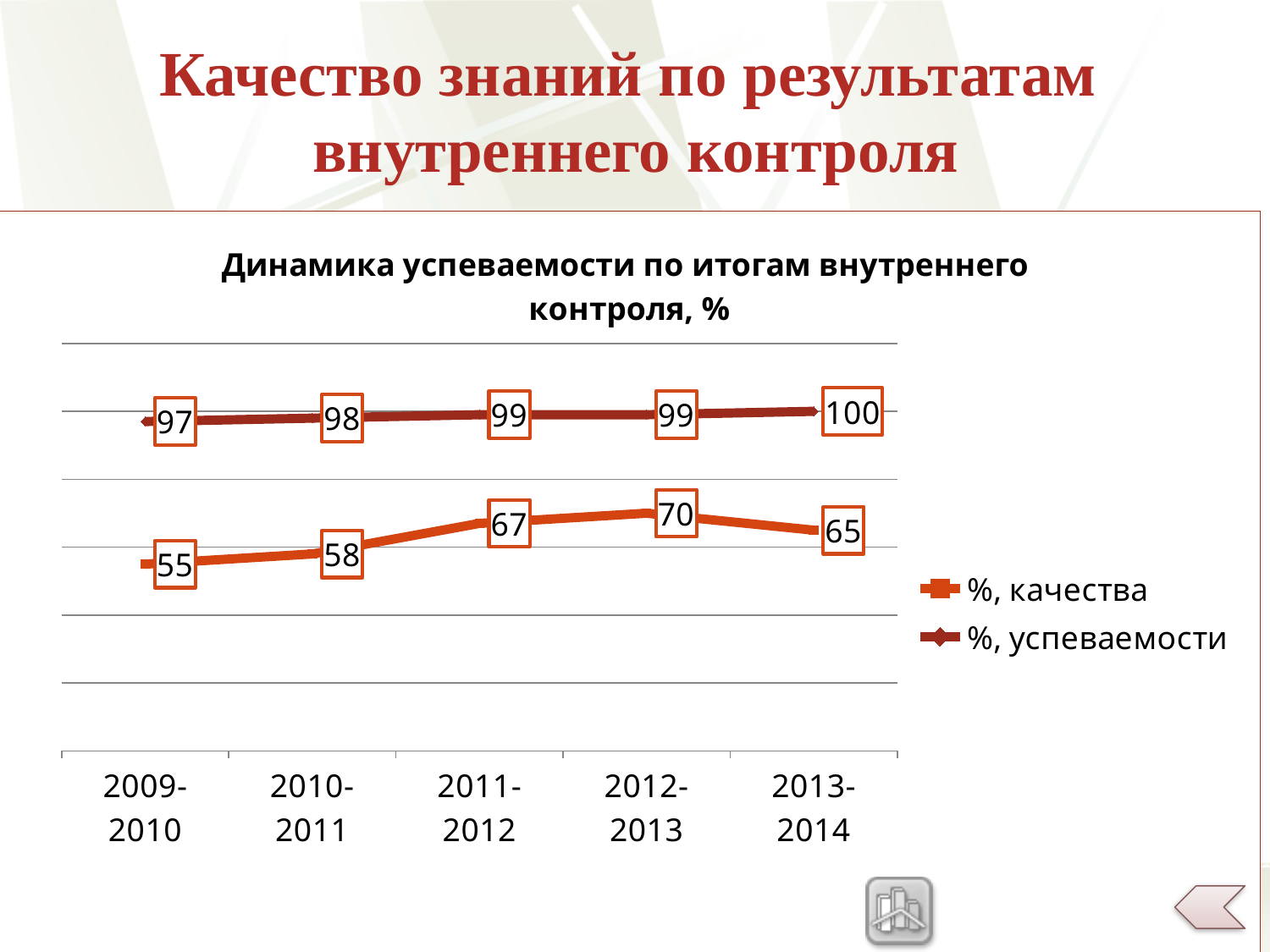
What is the value of "%, качества" for 2012-2013? 70 Which is larger: "%, качества" in 2011-2012 or in 2013-2014? 2011-2012 What is the value of "%, успеваемости" for 2009-2010? 97 What is the value of "%, качества" for 2013-2014? 65 In which year is "%, качества" highest? 2012-2013 How many years are shown on the x axis? 5 What kind of chart is shown? line chart What is the difference between "%, качества" in 2012-2013 and 2009-2010? 15 What is the title of the chart? Динамика успеваемости по итогам внутреннего контроля, % In which year is "%, качества" lowest? 2009-2010 Does "%, успеваемости" rise or fall from 2009-2010 to 2013-2014? rise How many series does the legend list? 2